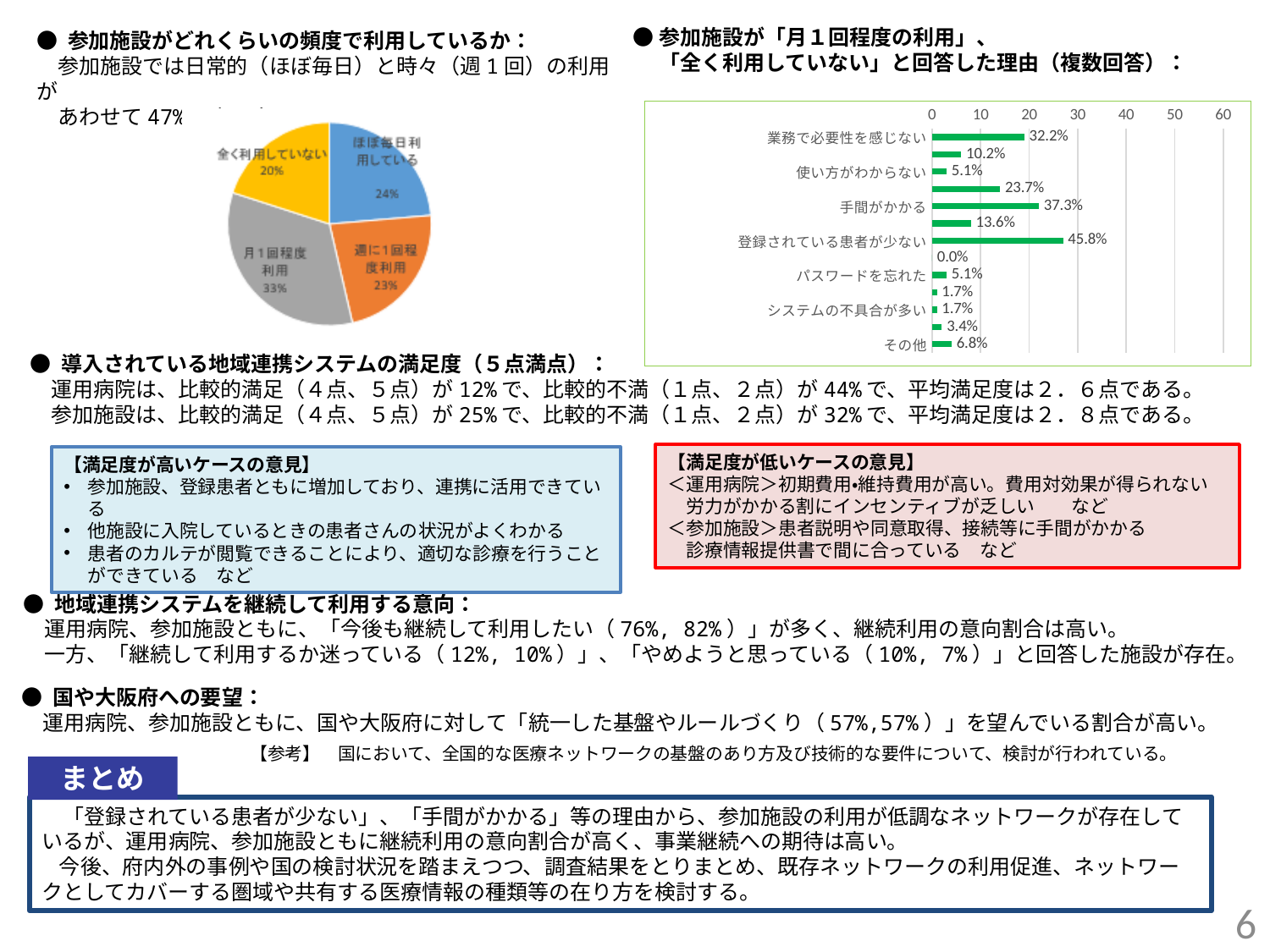
In the pie chart on the left, what percentage of participating facilities answered 「ほぼ毎日利用している」? 24% In the pie chart on the left, which category has the smallest share? 全く利用していない In the bar chart on the right, what is the value for 「登録されている患者が少ない」? 45.8% In the pie chart on the left, which category has the largest share? 月１回程度利用 In the bar chart on the right, what is the difference between 「業務で必要性を感じない」 and 「使い方がわからない」? 27.1% In the pie chart on the left, what percentage answered 「全く利用していない」? 20% In the pie chart on the left, how many categories are shown? 4 In the pie chart on the left, what percentage of participating facilities answered 「月１回程度利用」? 33% What type of chart is the chart on the right? bar chart In the pie chart on the left, what is the combined share of 「ほぼ毎日利用している」 and 「週に１回程度利用」? 47% In the bar chart on the right, which labeled reason has the highest value? 登録されている患者が少ない In the bar chart on the right, what is the value for 「手間がかかる」? 37.3%